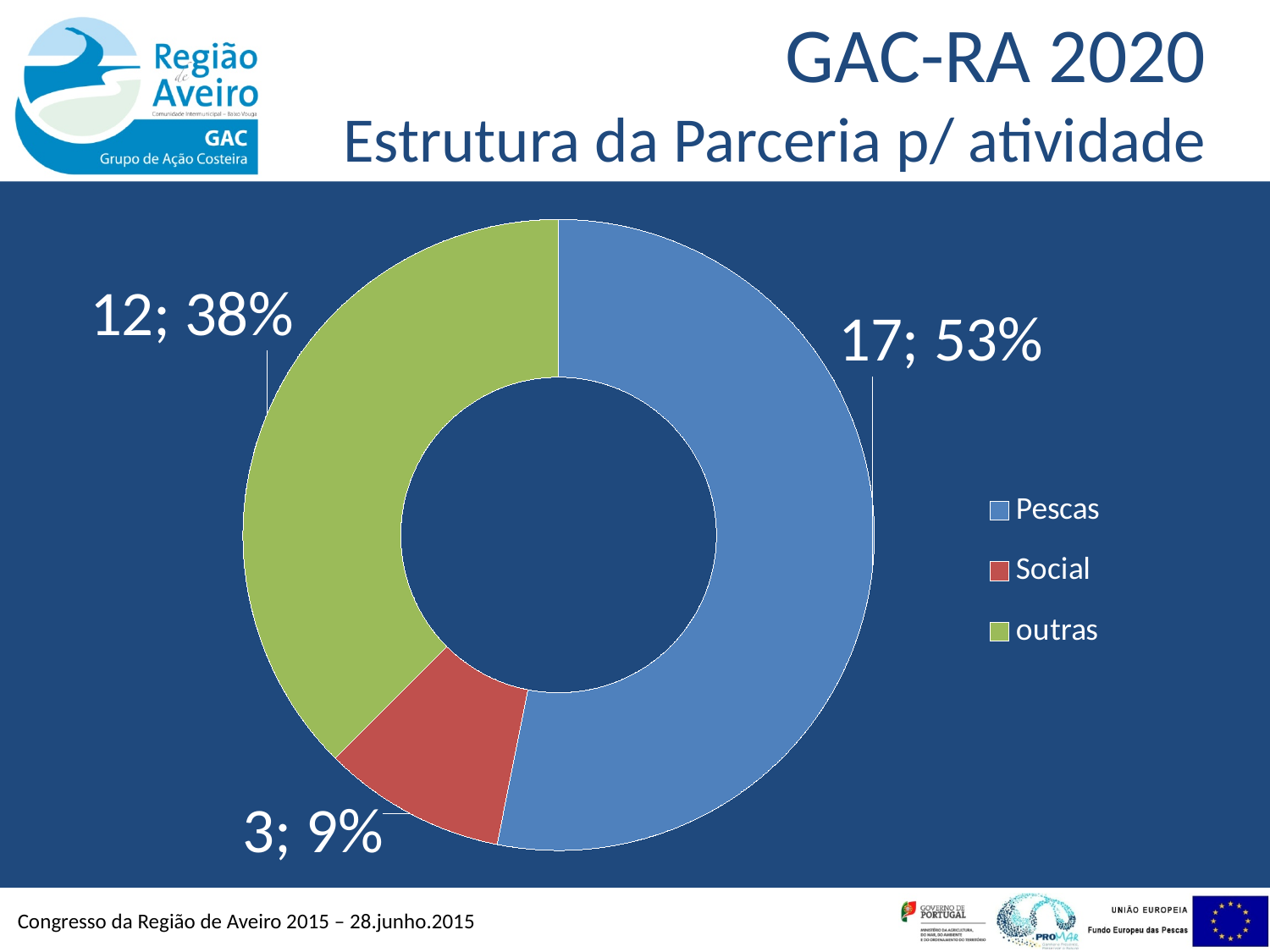
What share of the chart does outras represent? 38% What is the difference between the values for Pescas and outras? 5 Which category has the largest slice? Pescas What kind of chart is shown on the slide? Doughnut chart How many categories does the chart show? 3 What share of the chart does Pescas represent? 53% What is the value for Pescas? 17 What is the value for Social? 3 Which category has the smallest slice? Social How many entries does the legend list? 3 Which colour represents Social in the chart? Red What is the value for outras? 12